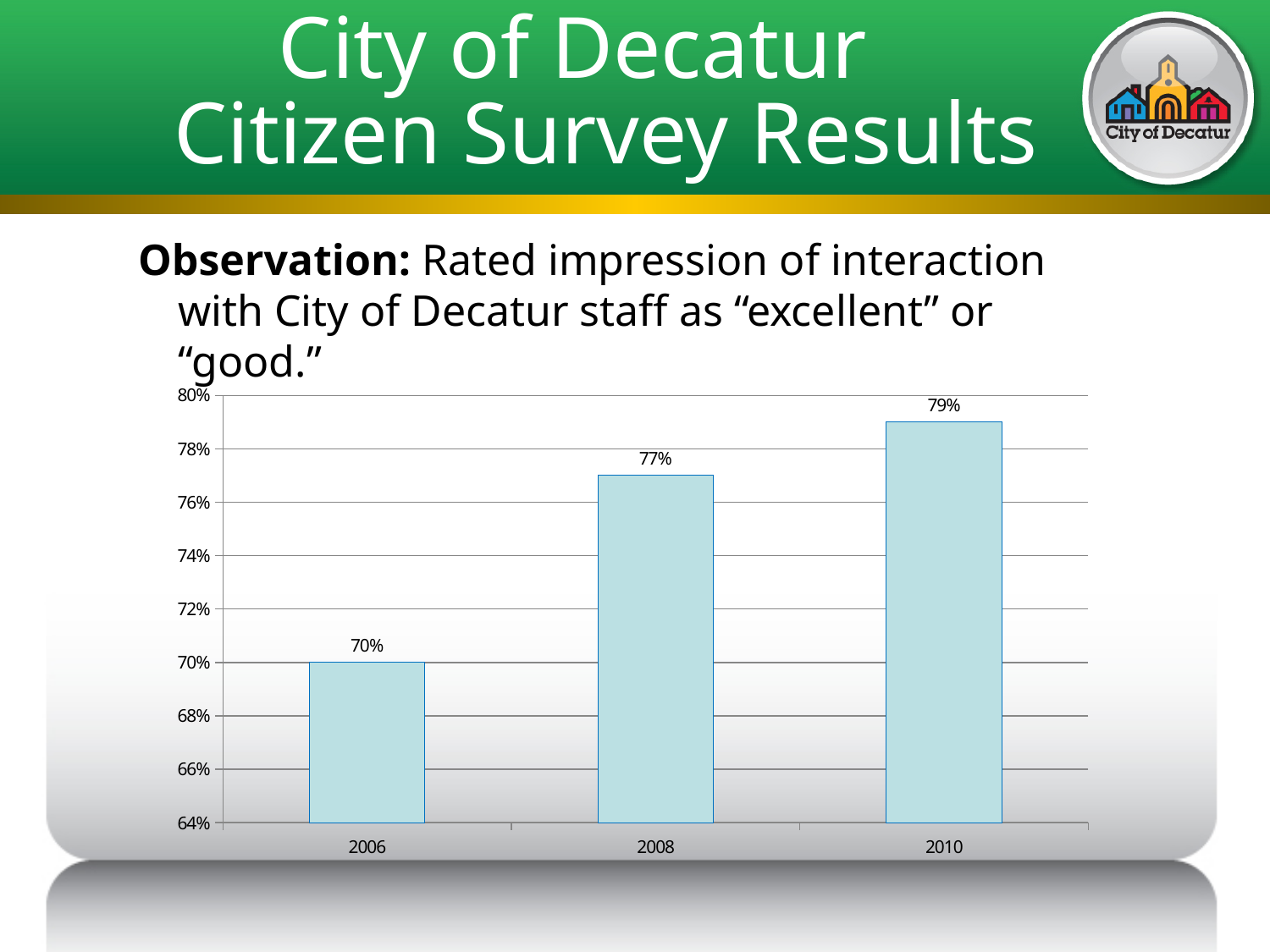
What value is shown for 2010? 79% What value is shown for 2008? 77% How many years are shown on the chart? 3 Is the value for 2008 greater or less than 74%? greater Do the values rise or fall from 2006 to 2010? Rise What value is shown for 2006? 70% Which is larger, the value for 2008 or the value for 2010? 2010 What is the difference between the values for 2010 and 2006? 9% Which year has the highest value? 2010 What kind of chart is shown on the slide? Bar chart What is the difference between the values for 2008 and 2006? 7% Which year has the lowest value? 2006